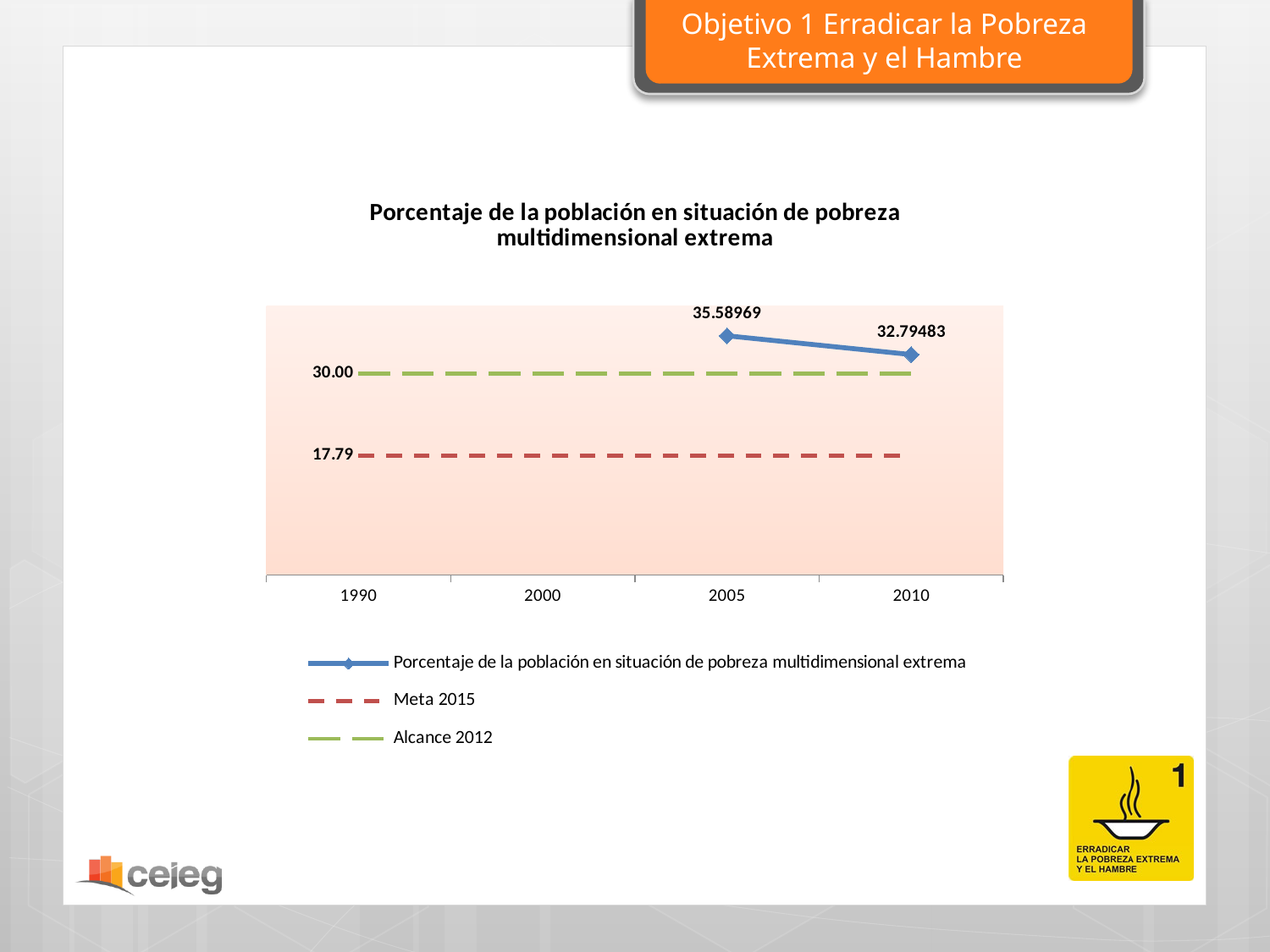
What is the value of the percentage of the population in extreme multidimensional poverty for 2005? 35.58969 What is the value of the percentage of the population in extreme multidimensional poverty for 2010? 32.79483 How many series does the legend list? 3 What kind of chart is shown on the slide? line chart What is the title of the chart? Porcentaje de la población en situación de pobreza multidimensional extrema Which year has the higher percentage of the population in extreme multidimensional poverty, 2005 or 2010? 2005 Does the percentage of the population in extreme multidimensional poverty rise or fall from 2005 to 2010? fall What value is shown for the Alcance 2012 line? 30.00 How many years are labelled on the x axis? 4 What value is shown for the Meta 2015 line? 17.79 By how much did the percentage of the population in extreme multidimensional poverty fall from 2005 to 2010? 2.79486 What is the difference between the 2010 value of the percentage of the population in extreme multidimensional poverty and the Meta 2015 value? 15.00483